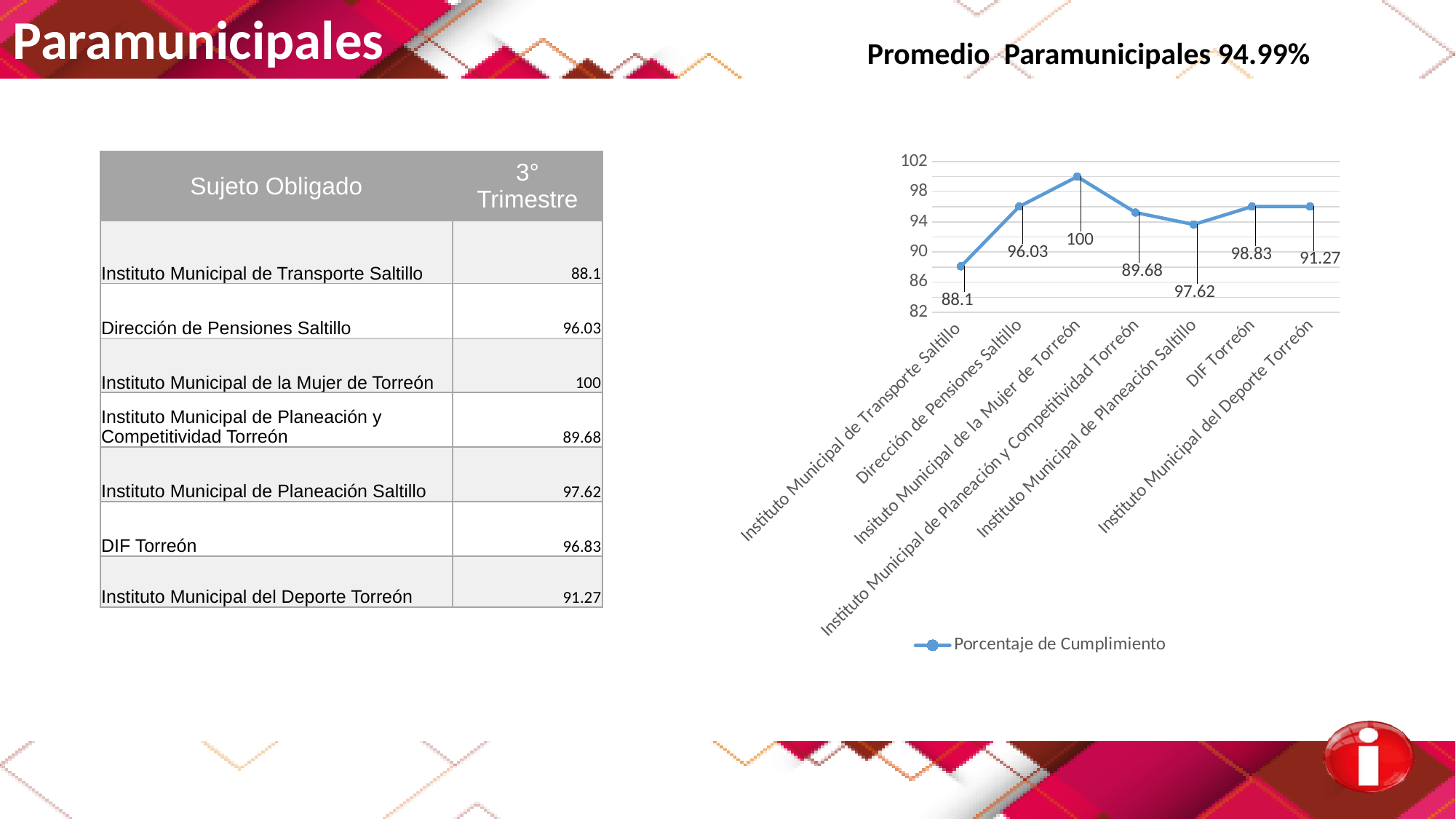
How many series does the chart legend list? 1 What is the name of the series shown in the chart legend? Porcentaje de Cumplimiento Which is larger: the value for Dirección de Pensiones Saltillo or the value for Instituto Municipal de Planeación y Competitividad Torreón? Dirección de Pensiones Saltillo What is the value for Instituto Municipal de Planeación y Competitividad Torreón in the chart? 89.68 Which category has the highest value in the chart? Instituto Municipal de la Mujer de Torreón What is the difference between the values for Instituto Municipal de la Mujer de Torreón and Instituto Municipal de Transporte Saltillo? 11.9 What is the value for Dirección de Pensiones Saltillo in the chart? 96.03 What is the value for Instituto Municipal de la Mujer de Torreón in the chart? 100 What type of chart is shown on the slide? line chart Which category has the lowest value in the chart? Instituto Municipal de Transporte Saltillo What is the value for Instituto Municipal de Transporte Saltillo in the chart? 88.1 How many categories are plotted on the x axis of the chart? 7